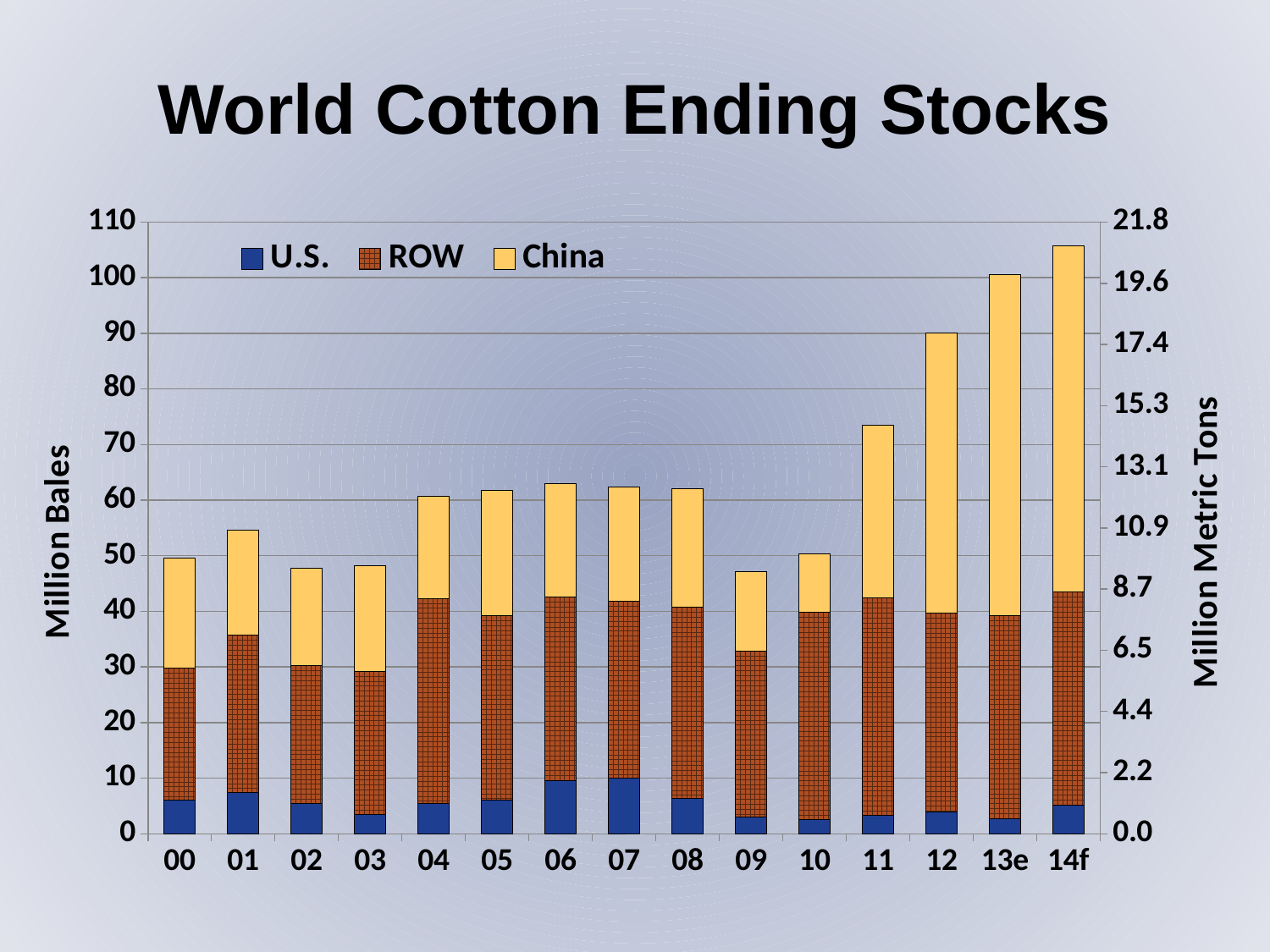
What is the title of the chart? World Cotton Ending Stocks Which year has the highest total ending stocks? 14f Is the total stacked bar for 14f greater or less than 100 million bales? greater Is the total stacked bar for 01 greater or less than 50 million bales? greater Is the total stacked bar for 09 greater or less than 50 million bales? less What is the label on the left vertical axis? Million Bales What kind of chart is shown on the slide? Stacked bar chart How many years (categories) are shown along the x axis? 15 Do total ending stocks rise or fall from 11 through 14f? rise Which has the larger total ending stocks, 13e or 12? 13e How many series does the legend list? 3